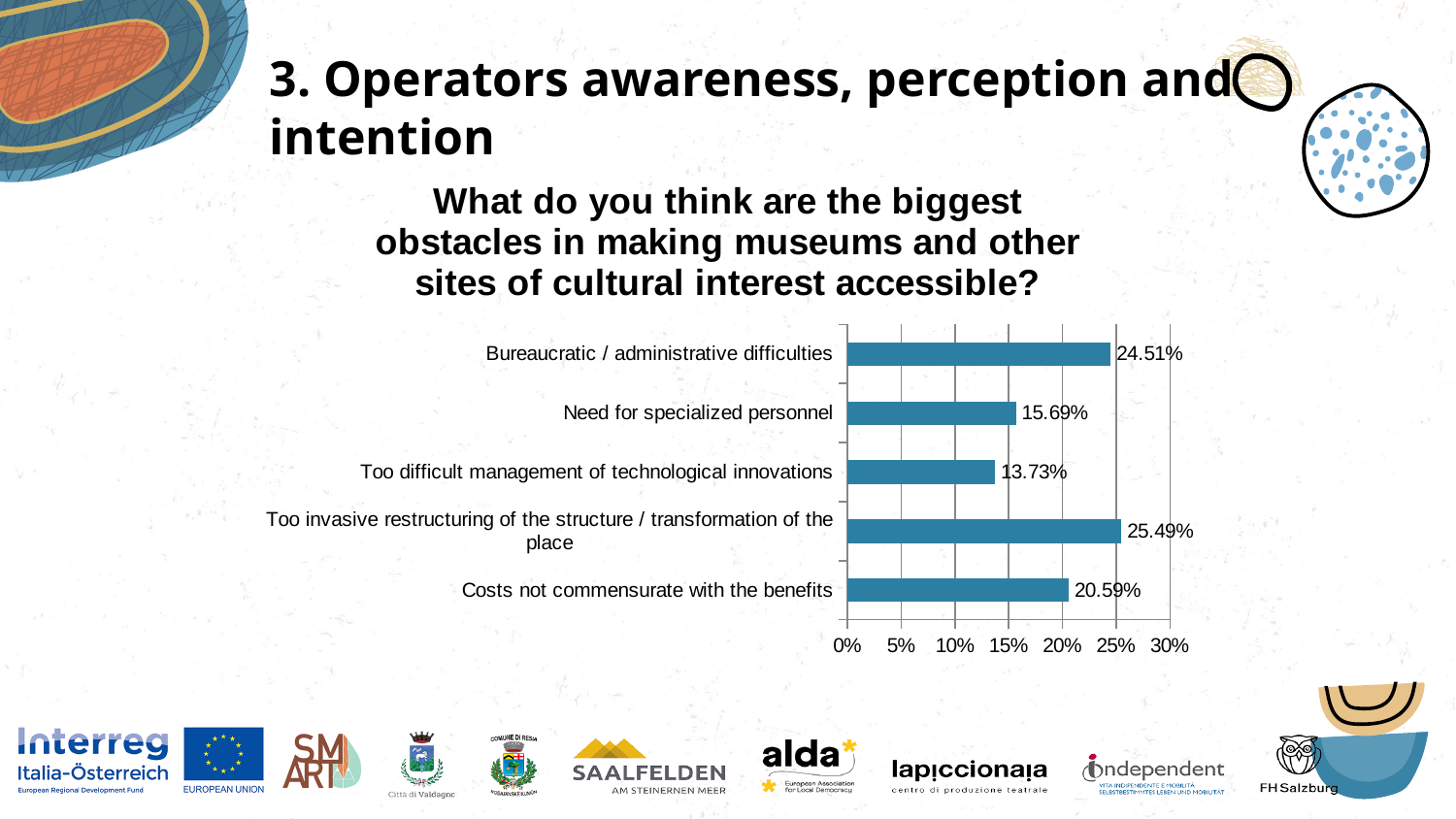
What question does the chart on the slide answer? What do you think are the biggest obstacles in making museums and other sites of cultural interest accessible? What percentage of respondents cited bureaucratic / administrative difficulties as an obstacle? 24.51% Which is larger: the value for 'Costs not commensurate with the benefits' or the value for 'Too difficult management of technological innovations'? Costs not commensurate with the benefits Which obstacle has the highest percentage in the chart? Too invasive restructuring of the structure / transformation of the place What is the difference between the values for 'Bureaucratic / administrative difficulties' and 'Need for specialized personnel'? 8.82% What type of chart is used on the slide? Bar chart What is the value shown for 'Costs not commensurate with the benefits'? 20.59% How many obstacle categories are shown in the chart? 5 What is the maximum value shown on the chart's percentage axis? 30% What is the value shown for 'Need for specialized personnel'? 15.69% Is the value for 'Need for specialized personnel' greater or less than 20%? less Which obstacle has the lowest percentage in the chart? Too difficult management of technological innovations